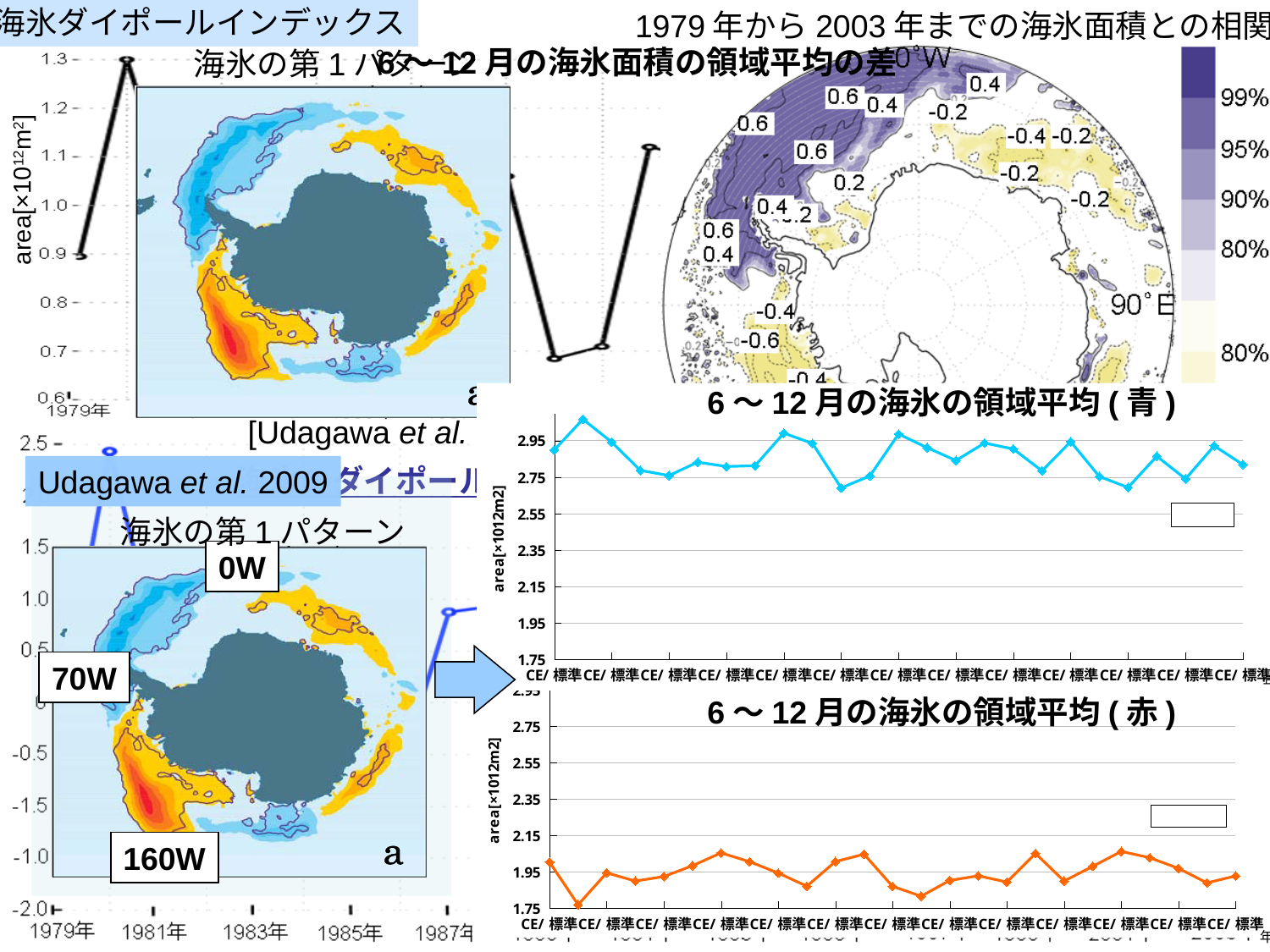
Comparing the two line charts on the right of the slide, which one shows higher area values overall, the 青 chart or the 赤 chart? 青 chart What is the y-axis label of the chart titled 6～12月の海氷の領域平均(青)? area[×1012m2] In the chart titled 6～12月の海氷の領域平均(青), are all the plotted values greater or less than 2.55? greater In the chart titled 6～12月の海氷の領域平均(赤), are all the plotted values greater or less than 2.35? less In the chart titled 6～12月の海氷の領域平均(青), is the highest point on the line greater or less than 2.95? greater What colour is the line in the chart titled 6～12月の海氷の領域平均(赤)? orange What kind of chart is the chart titled 6～12月の海氷の領域平均(赤)? line chart What kind of chart is the chart titled 6～12月の海氷の領域平均(青)? line chart In the chart titled 6～12月の海氷の領域平均(青), does the line rise steadily, fall steadily, or fluctuate up and down across the x axis? fluctuate up and down